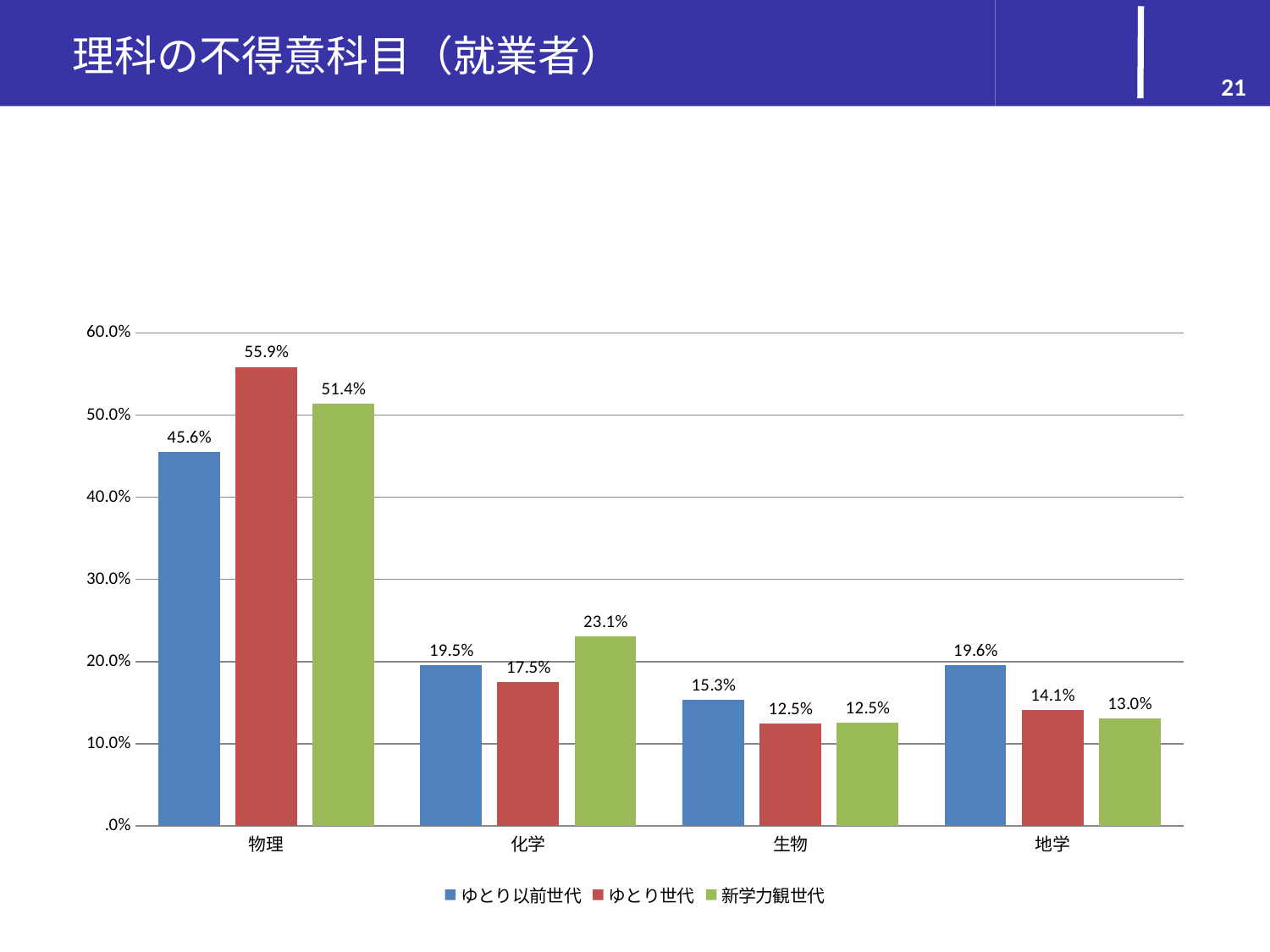
What is the value for ゆとり以前世代 in the 地学 category? 19.6% What is the difference between ゆとり世代 and ゆとり以前世代 in the 物理 category? 10.3% Which category has the highest value for ゆとり以前世代? 物理 Is the value for 新学力観世代 in the 物理 category greater or less than 50.0%? greater Which category has the lowest value for 新学力観世代? 生物 Which is larger in the 化学 category: ゆとり以前世代 or ゆとり世代? ゆとり以前世代 What is the title of the slide? 理科の不得意科目（就業者） How many series does the legend list? 3 What is the value for 新学力観世代 in the 化学 category? 23.1% What is the value for ゆとり世代 in the 物理 category? 55.9% How many categories are shown on the x axis? 4 What kind of chart is shown on the slide? bar chart